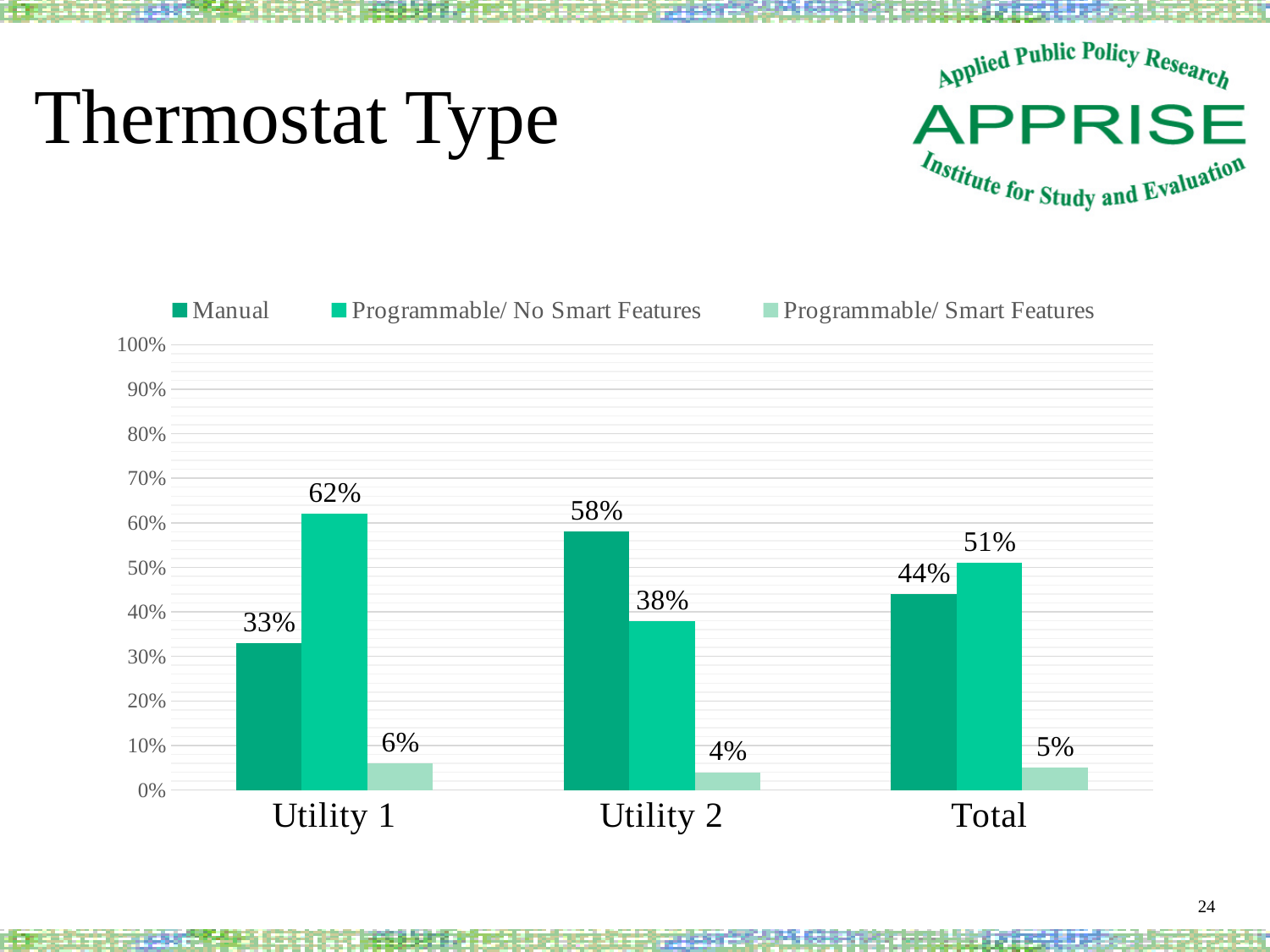
For Utility 1, which is larger: Manual or Programmable/ No Smart Features? Programmable/ No Smart Features Which category has the lowest value for Programmable/ Smart Features? Utility 2 What is the value for Programmable/ No Smart Features for Utility 2? 38% Is the Manual value for Utility 2 greater or less than 50%? greater What is the difference between the Programmable/ No Smart Features values for Utility 1 and Utility 2? 24% How many series does the legend list? 3 What kind of chart is shown on the slide? Bar chart What is the title of the slide containing the chart? Thermostat Type Which category has the highest value for Manual thermostats? Utility 2 How many categories are shown on the x axis? 3 What percentage of Utility 1 households have a Manual thermostat? 33% What is the Total value for Programmable/ Smart Features? 5%